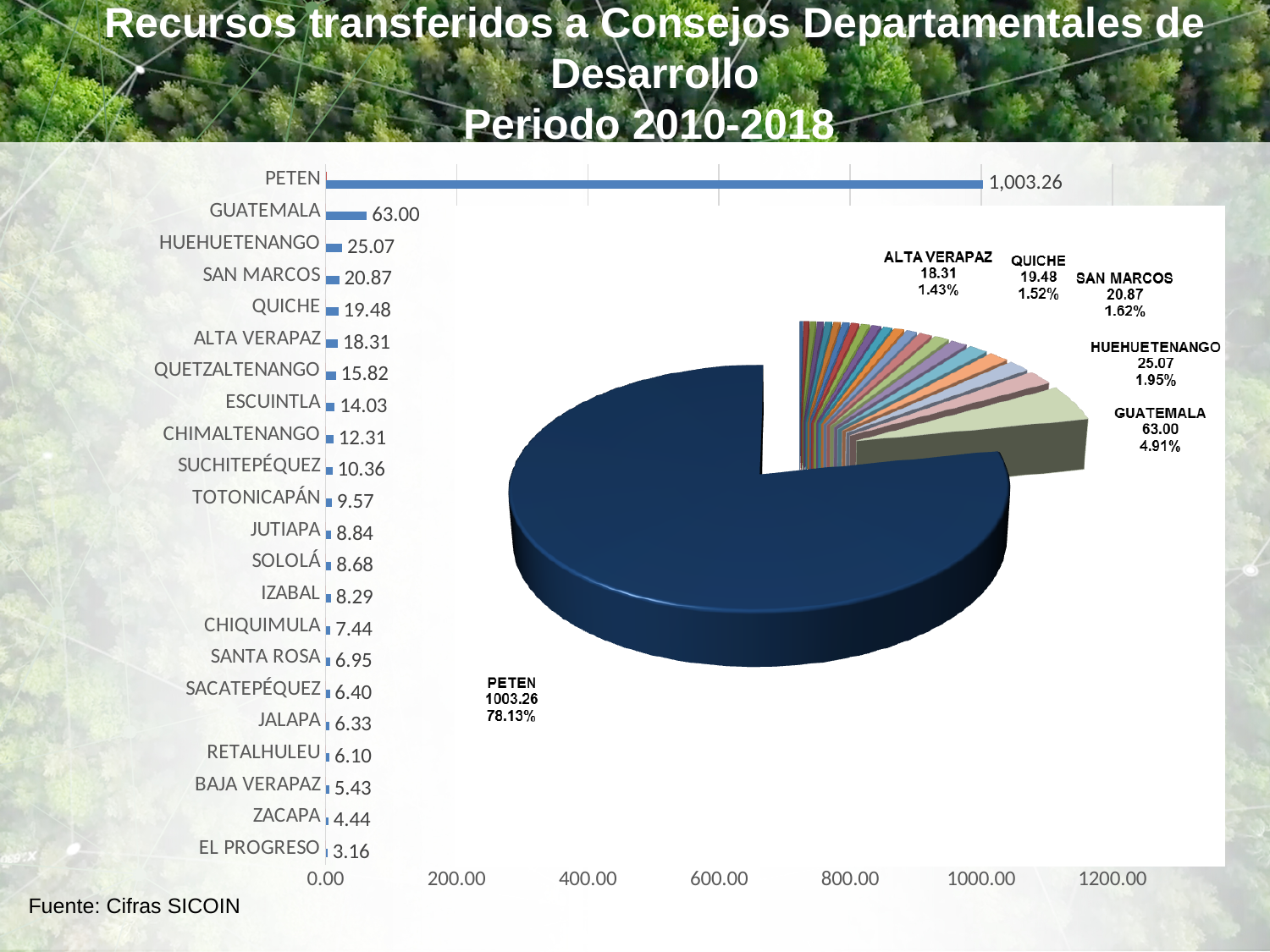
In the bar chart on the left, what is the value for PETEN? 1,003.26 In the bar chart on the left, which category has the highest value? PETEN What kind of chart is the chart on the left of the slide? bar chart In the bar chart on the left, which category has the lowest value? EL PROGRESO In the bar chart on the left, what is the difference between the values for GUATEMALA and HUEHUETENANGO? 37.93 In the bar chart on the left, which is larger, the value for QUICHE or the value for ALTA VERAPAZ? QUICHE In the bar chart on the left, is the value for PETEN greater or less than 800.00? greater In the bar chart on the left, what is the value for EL PROGRESO? 3.16 How many categories does the bar chart on the left show? 22 In the bar chart on the left, what is the value for HUEHUETENANGO? 25.07 In the pie chart on the right, what share of the total does PETEN represent? 78.13% In the pie chart on the right, what share of the total does GUATEMALA represent? 4.91%